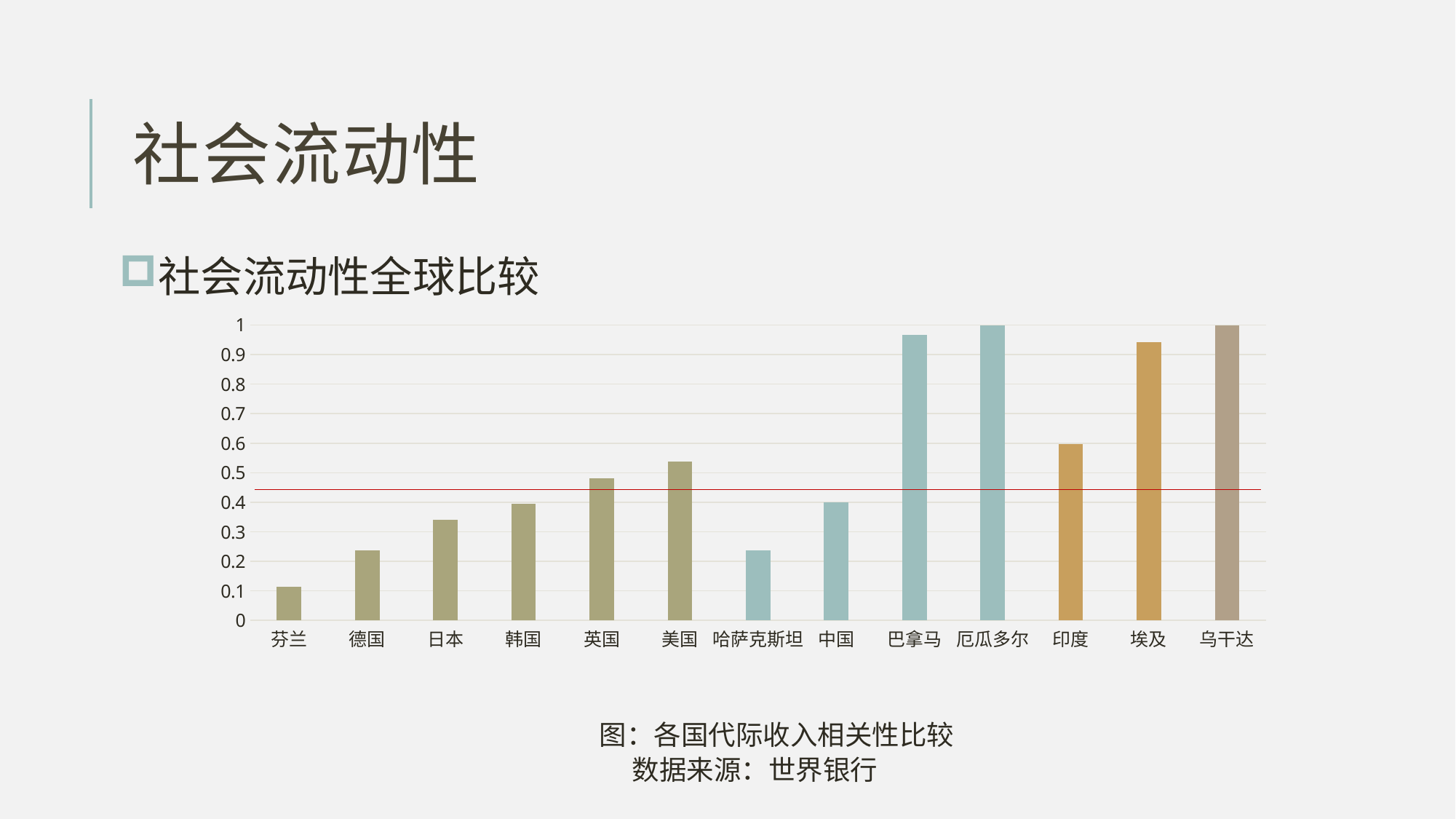
Is the value for 埃及 greater or less than 0.8? greater What kind of chart is shown on the slide? bar chart Which has a higher value, 美国 or 英国? 美国 How many countries are shown on the x axis of the chart? 13 Which country has the lowest value in the chart? 芬兰 What is the data source stated for the chart? 世界银行 Which has a higher value, 日本 or 韩国? 韩国 Is the value for 巴拿马 greater or less than 0.9? greater Is the value for 中国 greater or less than 0.5? less What is the caption given below the chart? 图：各国代际收入相关性比较